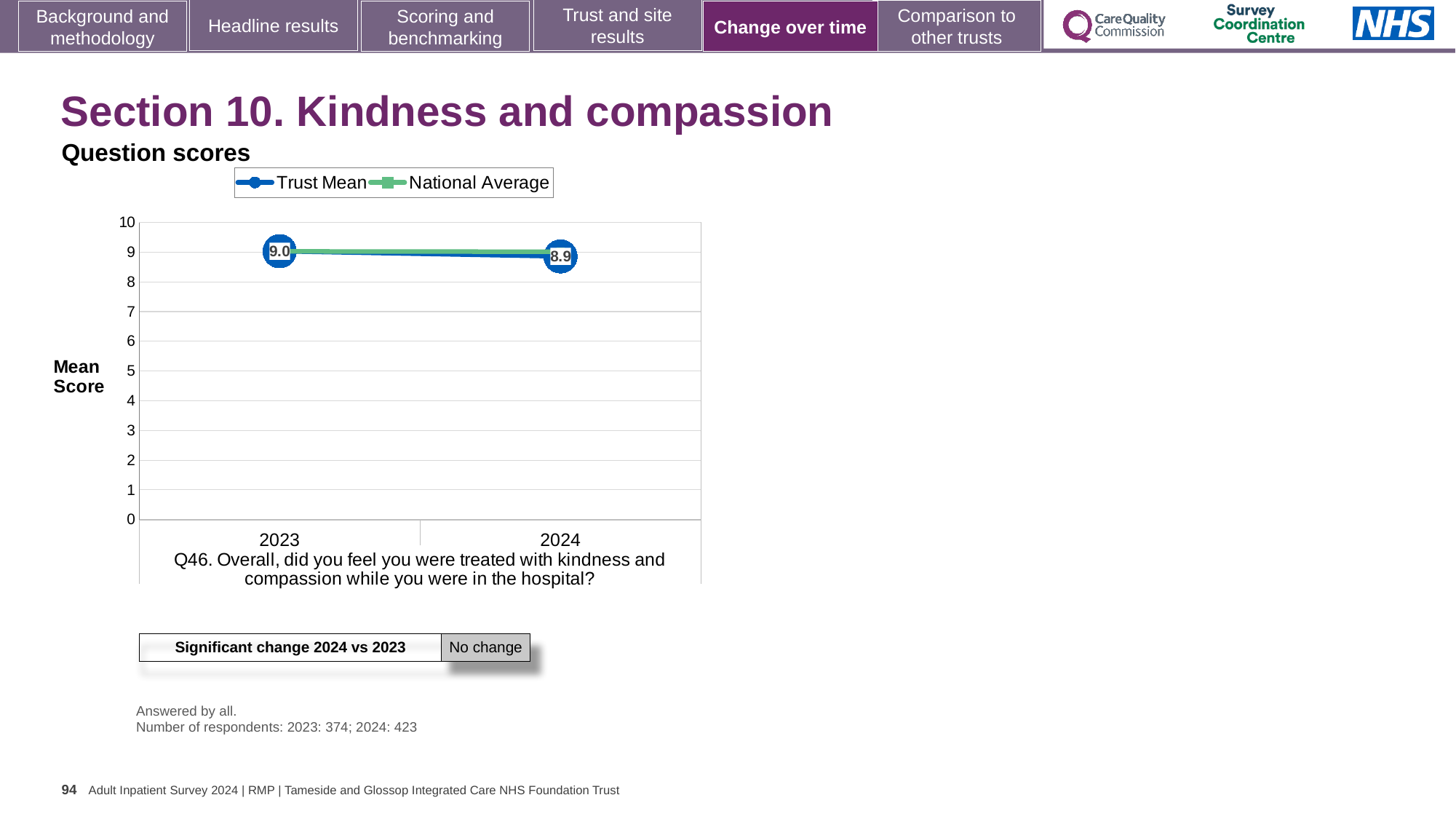
What are the two series named in the chart legend? Trust Mean and National Average What is the Trust Mean score for 2023? 9.0 Which year has the higher Trust Mean score? 2023 What is the difference between the Trust Mean scores for 2023 and 2024? 0.1 Is the Trust Mean score for 2023 larger or smaller than the Trust Mean score for 2024? larger Does the Trust Mean score rise or fall from 2023 to 2024? fall What kind of chart is shown on the slide? line chart Is the Trust Mean value for 2024 greater or less than 8? greater How many years are plotted on the x axis of the chart? 2 How many series does the chart legend list? 2 Which year has the lower Trust Mean score? 2024 What is the Trust Mean score for 2024? 8.9